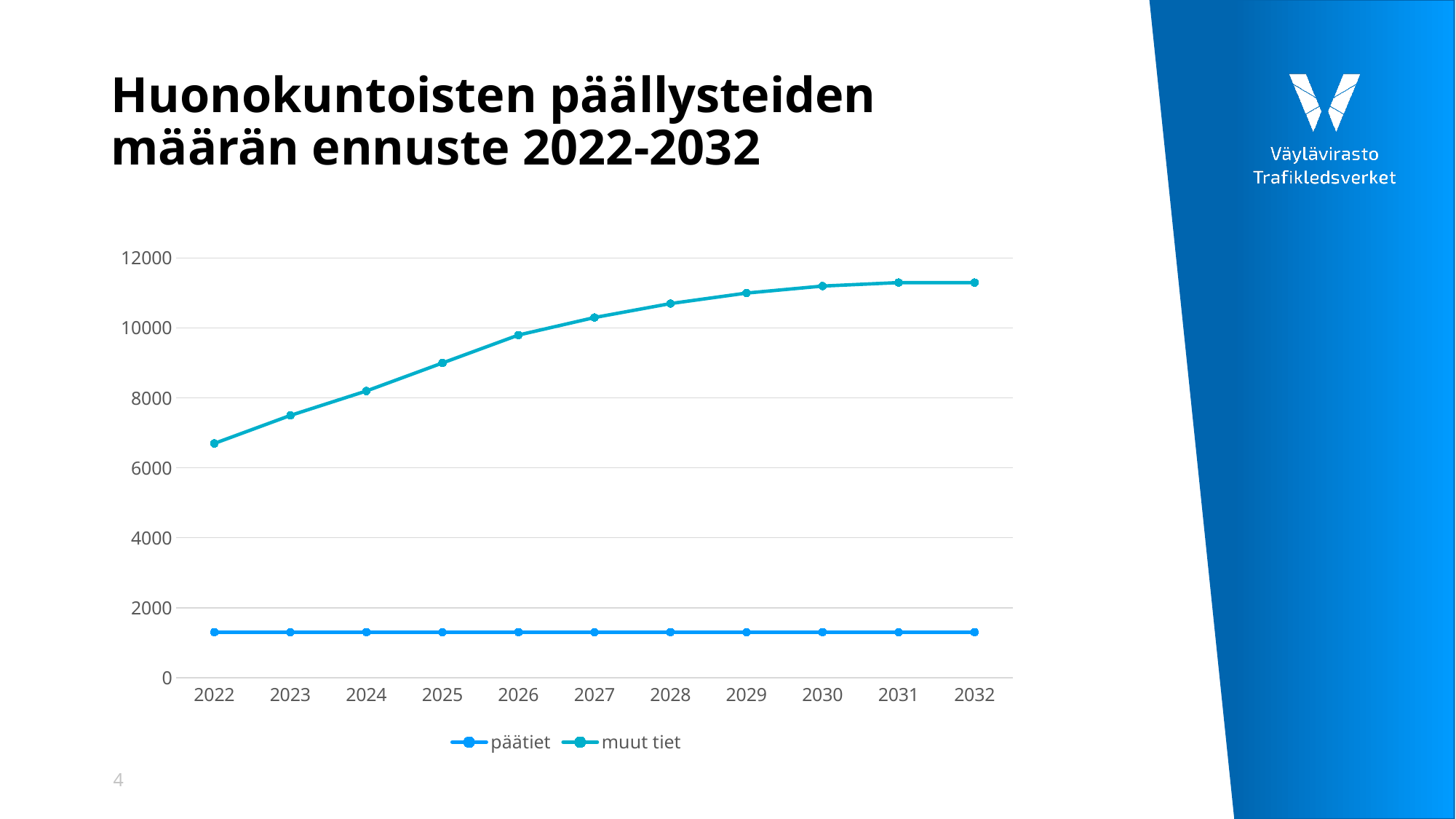
In which year is the value for muut tiet lowest? 2022 How many years are plotted along the x axis? 11 Is the value for muut tiet in 2028 greater or less than 10000? greater How many series does the legend list? 2 Is the value for muut tiet in 2032 greater or less than 12000? less Do the values for muut tiet rise or fall from 2022 to 2032? rise Which series has the larger value in 2030, päätiet or muut tiet? muut tiet Is the value for muut tiet in 2022 greater or less than 6000? greater What is the title of the slide? Huonokuntoisten päällysteiden määrän ennuste 2022-2032 Do the values for päätiet rise, fall or stay flat from 2022 to 2032? stay flat What kind of chart is shown on the slide? line chart